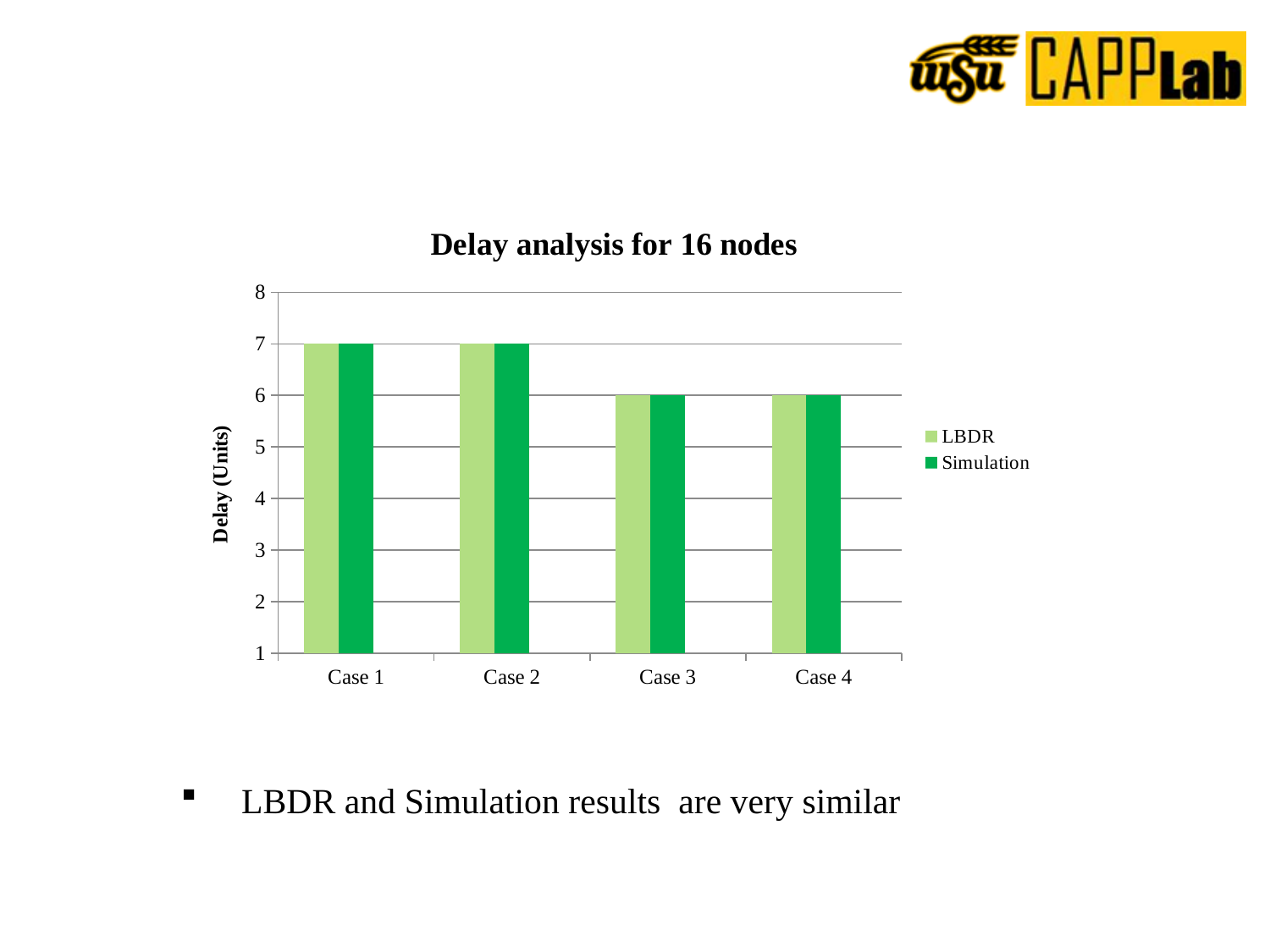
What type of chart is shown on the slide? Bar chart Which is larger, the LBDR delay for Case 2 or the LBDR delay for Case 3? Case 2 What is the LBDR delay for Case 1? 7 What is the title of the chart? Delay analysis for 16 nodes Do the LBDR delay values rise or fall from Case 1 to Case 4? Fall How many cases are shown on the x axis? 4 What is the Simulation delay for Case 3? 6 How many series does the legend list? 2 What is the label of the y axis? Delay (Units) What is the Simulation delay for Case 2? 7 What is the LBDR delay for Case 4? 6 What is the difference between the Simulation delay for Case 1 and the Simulation delay for Case 4? 1